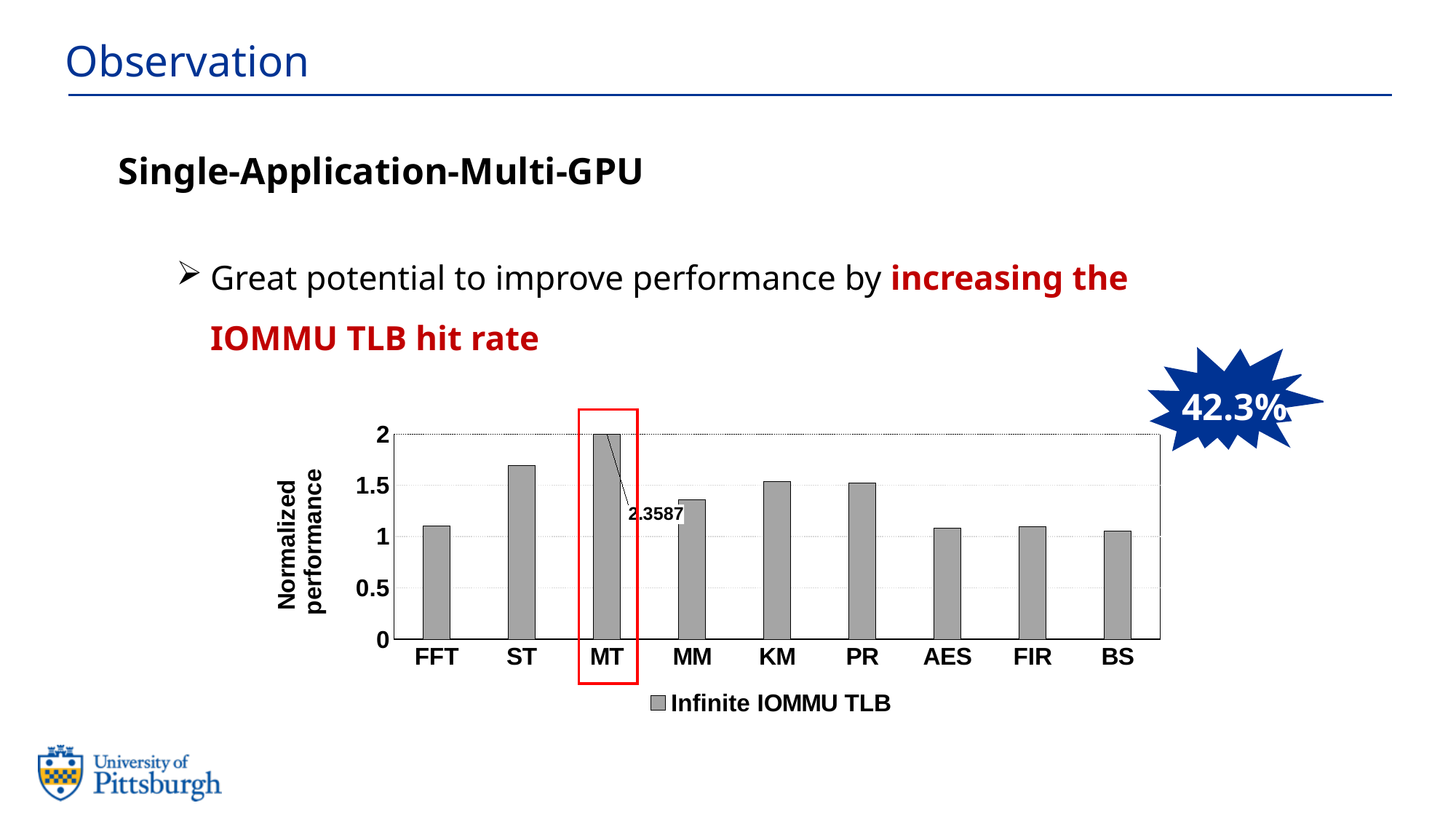
What is the label of the chart's y axis? Normalized performance How many categories (benchmarks) are shown on the x axis of the chart? 9 How many series does the chart's legend list? 1 Which has the larger normalized performance, FFT or ST? ST Is the value for ST greater or less than 1.5? greater What series name is shown in the chart's legend? Infinite IOMMU TLB Which benchmark has the highest normalized performance? MT Is the value for AES greater or less than 1.5? less What is the normalized performance value labeled for MT? 2.3587 What type of chart is shown on the slide? bar chart Is the value for MM greater or less than 1.5? less Which has the larger normalized performance, ST or MM? ST